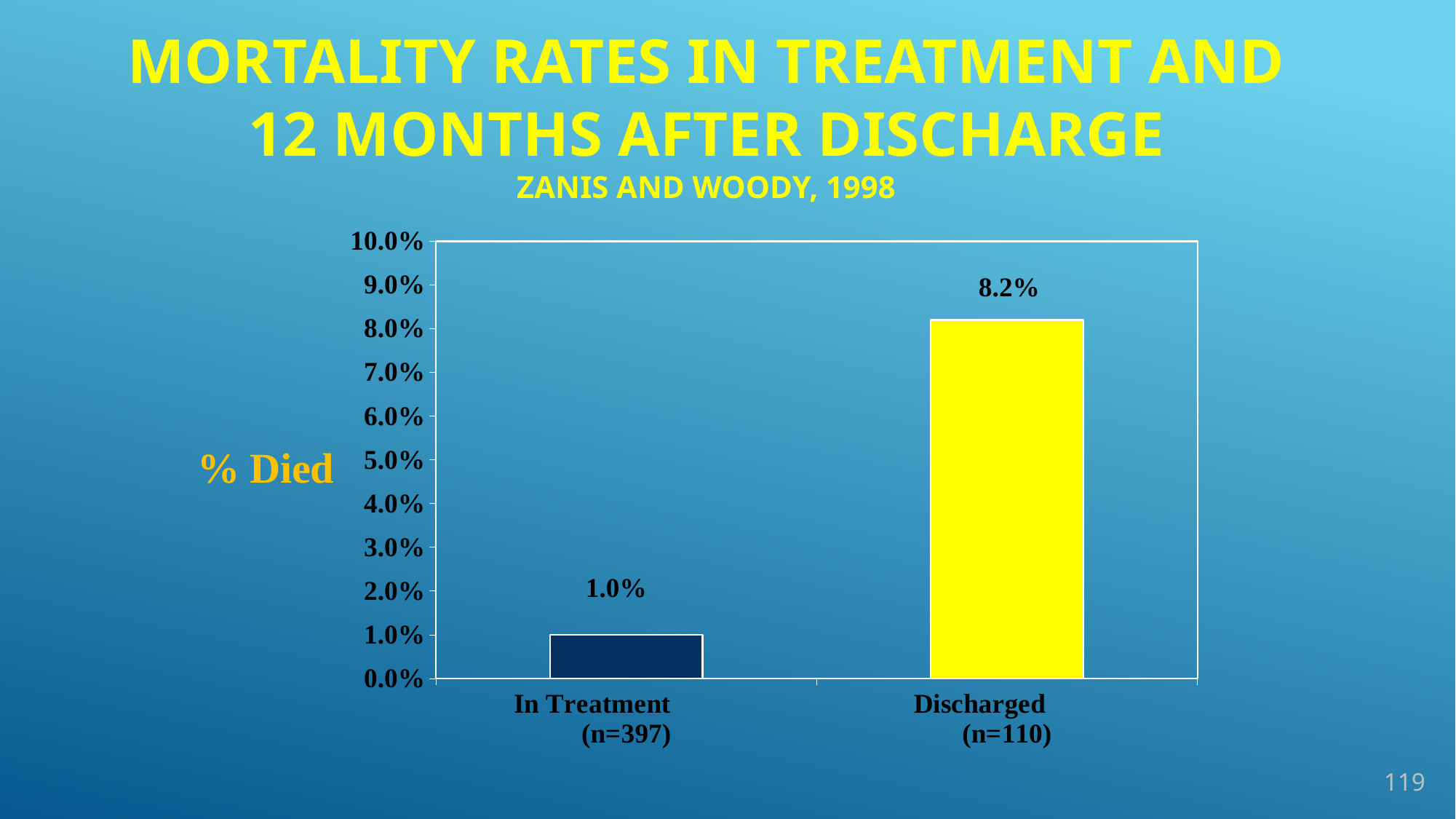
What is the mortality rate for the Discharged (n=110) group? 8.2% What is the label on the vertical axis of the chart? % Died What is the maximum value shown on the vertical axis? 10.0% What is the mortality rate for the In Treatment (n=397) group? 1.0% Is the mortality rate for the In Treatment group greater or less than 2.0%? less What kind of chart is shown on the slide? Bar chart Which group has the higher mortality rate? Discharged (n=110) How many groups are shown on the chart? 2 Is the Discharged bar larger or smaller than the In Treatment bar? larger Which group has the lower mortality rate? In Treatment (n=397) What is the difference in mortality rate between the Discharged and In Treatment groups? 7.2% Is the mortality rate for the Discharged group greater or less than 8.0%? greater